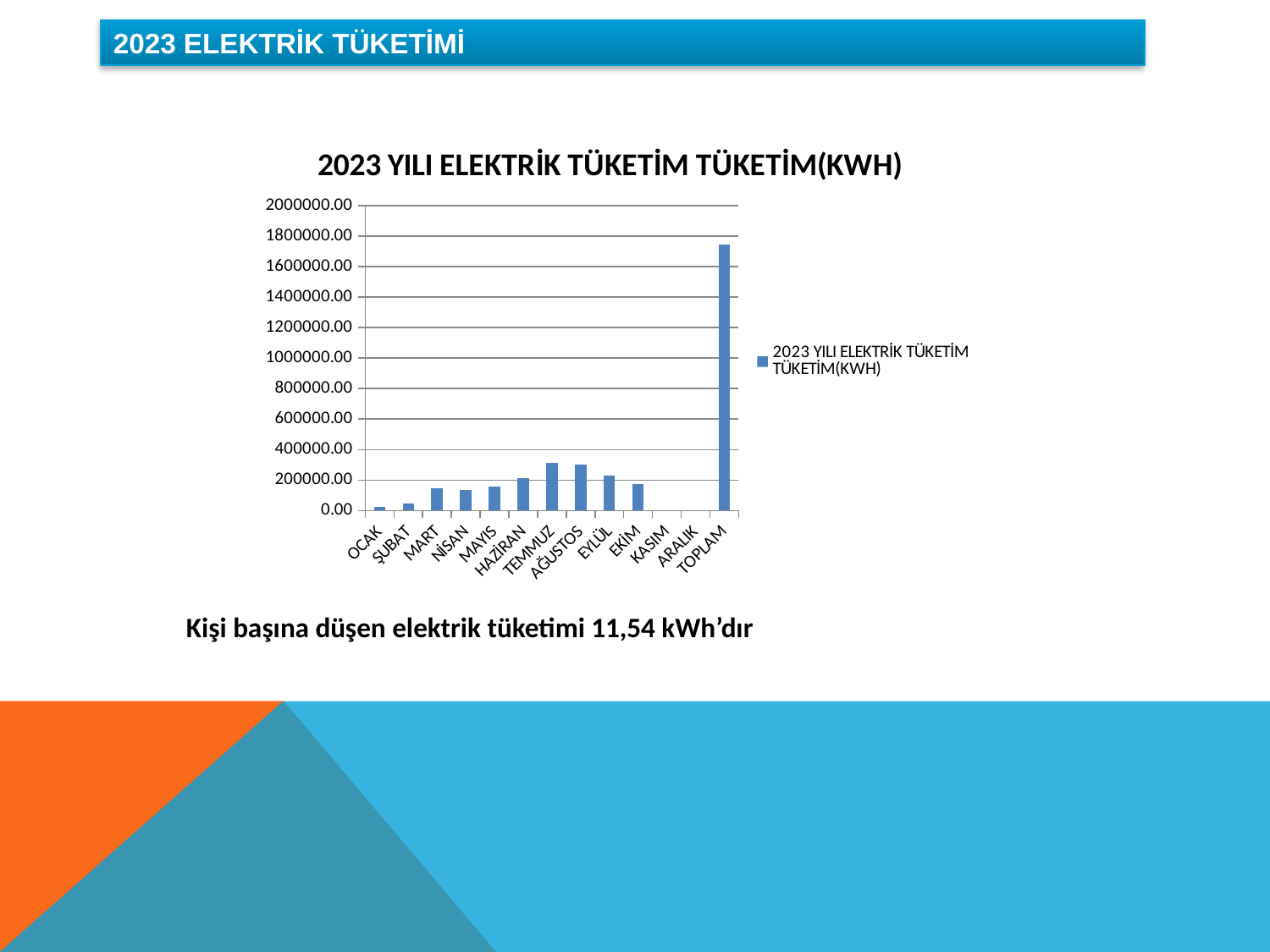
How many series does the legend list? 1 How many categories are shown on the x axis? 13 Which is larger, the value for EYLÜL or the value for EKİM? EYLÜL Do the values rise or fall from OCAK to TEMMUZ? rise Is the value for MART greater or less than 200000.00? less What kind of chart is shown on the slide? bar chart Is the value for TEMMUZ greater or less than 200000.00? greater Is the value for OCAK greater or less than 200000.00? less What is the title of the chart? 2023 YILI ELEKTRİK TÜKETİM TÜKETİM(KWH) Which category has the tallest bar? TOPLAM Which is larger, the value for TEMMUZ or the value for OCAK? TEMMUZ